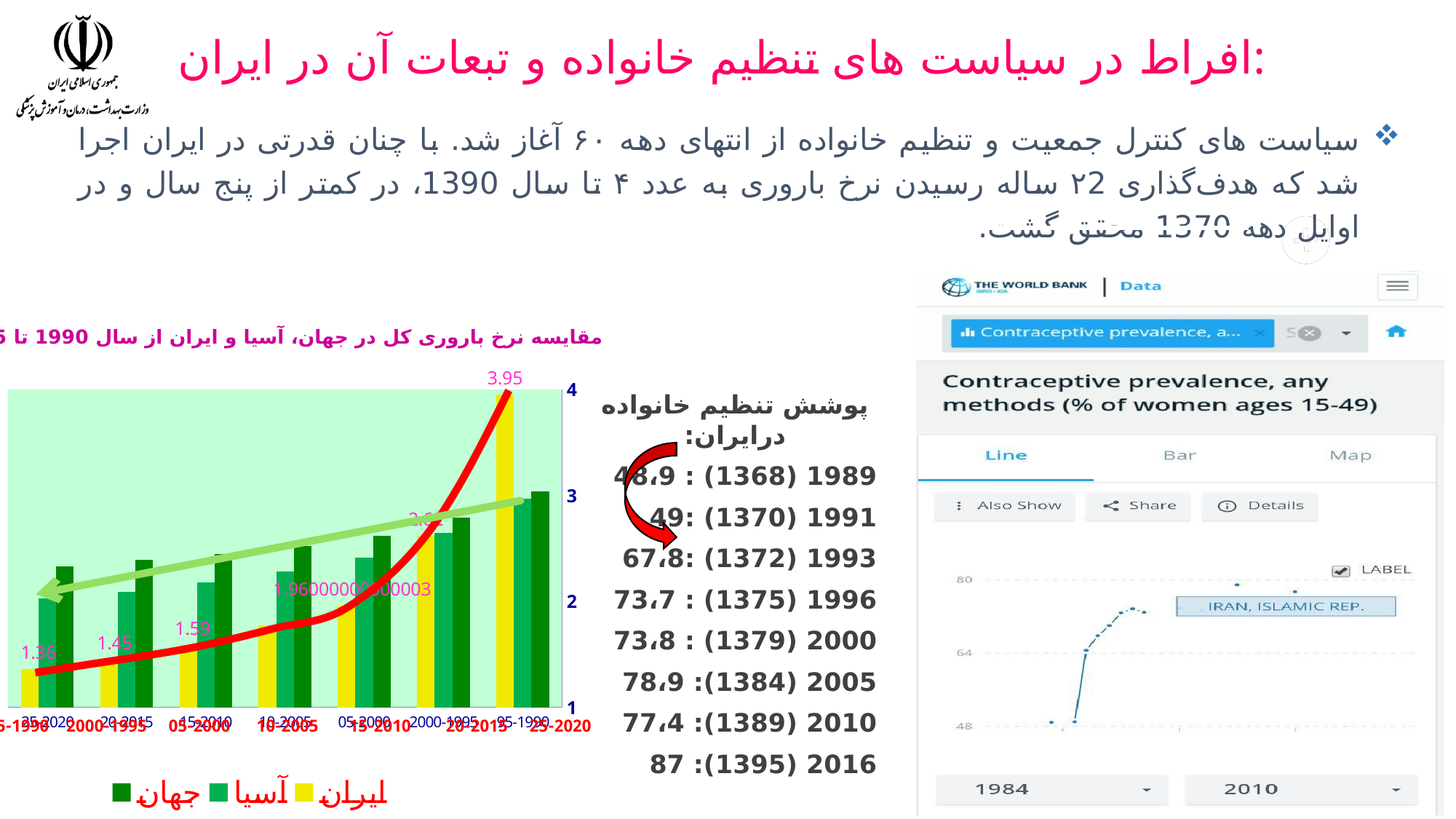
In the left bar chart, what is the difference between the highest yellow (ایران) data label (3.95) and the lowest (1.36)? 2.59 In the left bar chart, which series has the shortest bar in the leftmost group of bars? ایران In the left bar chart, what is the data label on the second yellow (ایران) bar from the left? 1.45 How many series does the legend of the left bar chart list? 3 What kind of chart is the chart on the left of the slide? bar chart In the left bar chart, do the yellow (ایران) bars rise or fall from left to right? rise In the left bar chart, what is the data label on the leftmost yellow (ایران) bar? 1.36 In the left bar chart, is the leftmost dark green (جهان) bar greater or less than 2? greater In the left bar chart, what is the highest data label shown on the yellow (ایران) bars? 3.95 In the left bar chart, what is the data label on the third yellow (ایران) bar from the left? 1.59 In the left bar chart, which series has the tallest bar in the rightmost group of bars? ایران What are the three legend entries of the left bar chart? ایران, آسیا, جهان